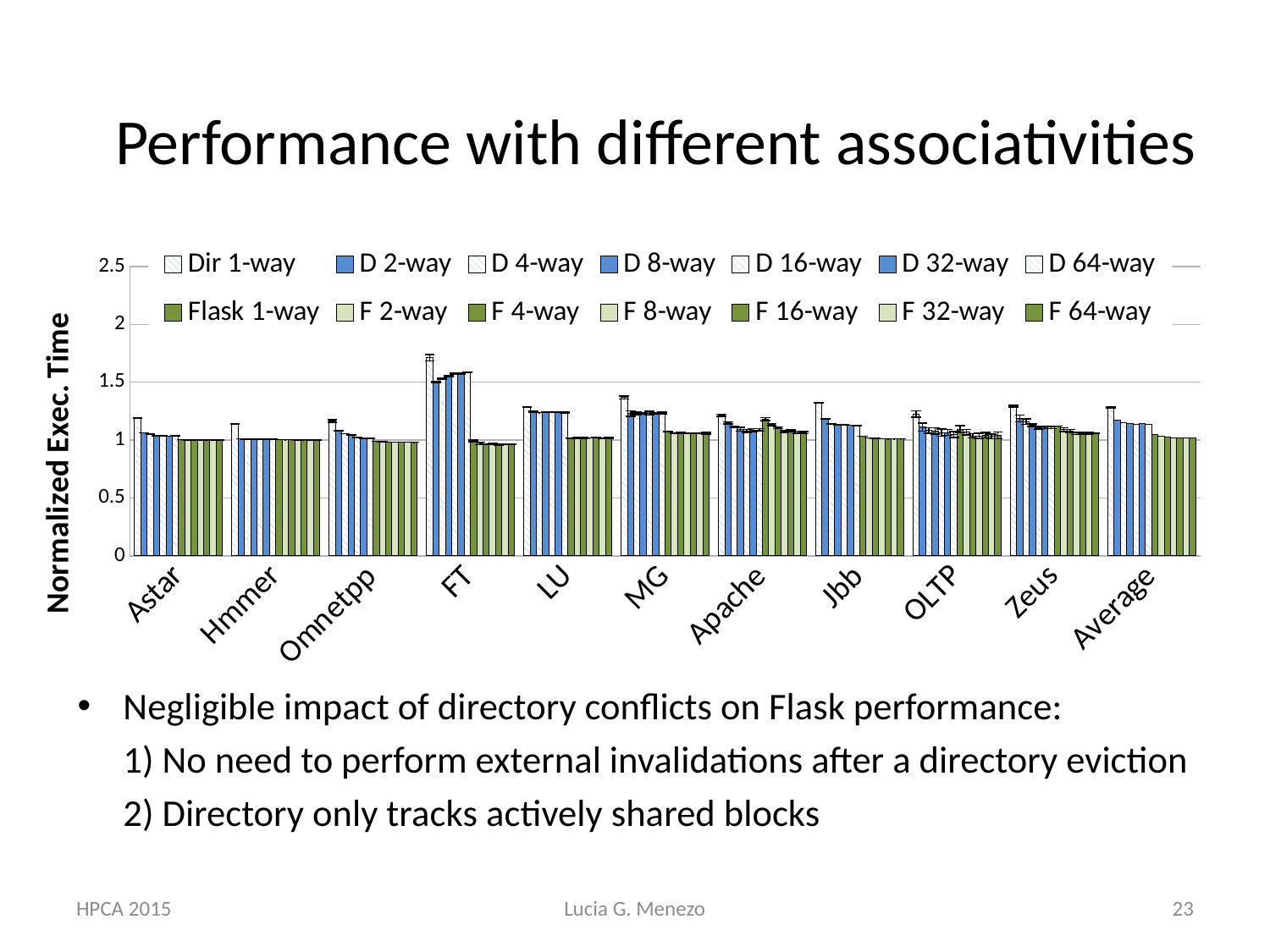
What is the first series listed in the chart's legend? Dir 1-way How many categories (benchmarks) are shown along the x axis of the chart? 11 Is the Dir 1-way value for MG greater or less than 1.5? less Is the Dir 1-way value for Hmmer greater or less than 1? greater What kind of chart is shown on the slide? bar chart Is the Dir 1-way value for FT greater or less than 1.5? greater For FT, which is larger: the Dir 1-way bar or the Flask 1-way bar? Dir 1-way What is the label of the chart's y axis? Normalized Exec. Time Which category has the highest Dir 1-way bar? FT Which is larger: the Dir 1-way bar for FT or the Dir 1-way bar for Hmmer? FT How many series does the chart's legend list? 14